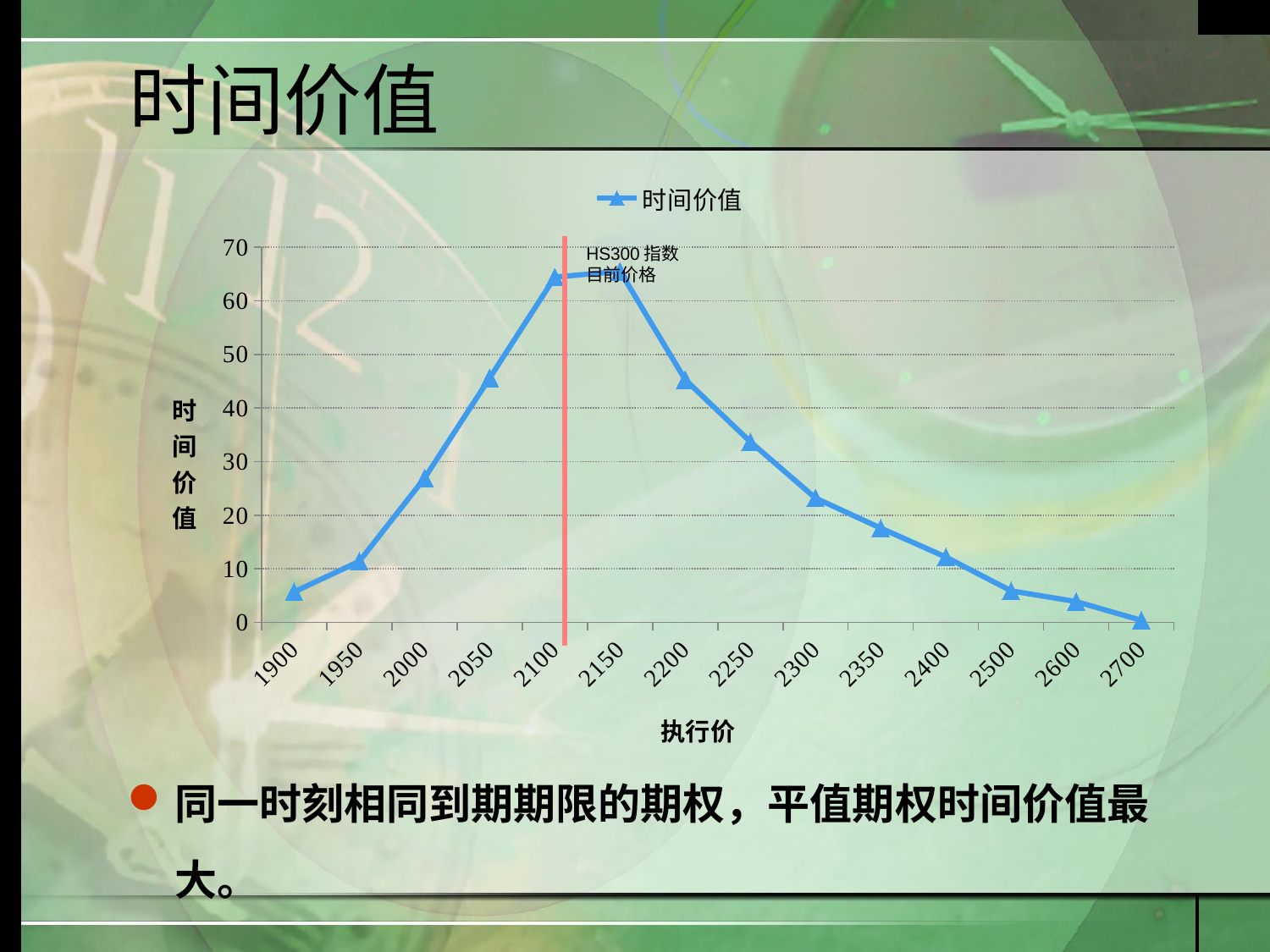
Is the 时间价值 at 执行价 2500 greater or less than 10? less Does the 时间价值 rise or fall as 执行价 increases from 2150 to 2700? fall What kind of chart is shown on the slide? line chart How many 执行价 categories are plotted along the x axis? 14 What does the red vertical line on the chart mark? HS300 指数目前价格 How many series does the legend list? 1 What is the name of the series shown in the legend? 时间价值 Which 执行价 has the lowest 时间价值? 2700 Is the 时间价值 at 执行价 2100 greater or less than 60? greater Which has the larger 时间价值, 执行价 2050 or 执行价 2300? 2050 Is the 时间价值 at 执行价 2000 greater or less than 20? greater